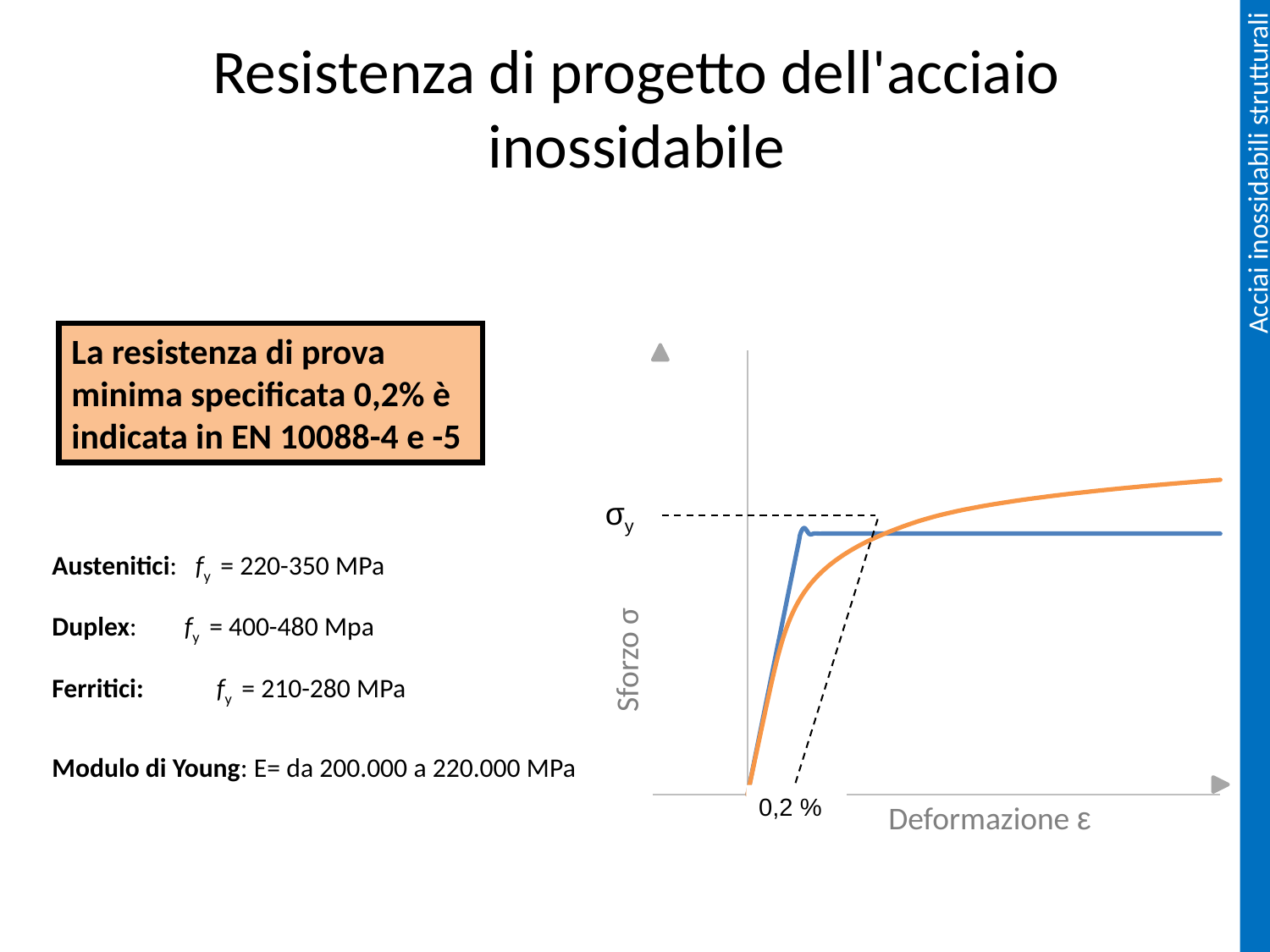
At the right end of the chart, which curve is higher, the orange one or the blue one? the orange one Which curve becomes flat (horizontal) after reaching σy, the blue one or the orange one? the blue one How many curves are plotted on the chart? 2 What is the label of the horizontal axis of the chart? Deformazione ε What kind of chart is shown on the slide? line chart Do the curves rise or fall as the deformation ε increases along the x axis? rise What is the label of the vertical axis of the chart? Sforzo σ What strain value is marked on the horizontal axis where the dashed offset line starts? 0,2 % What symbol marks the stress level indicated by the horizontal dashed line on the vertical axis? σy